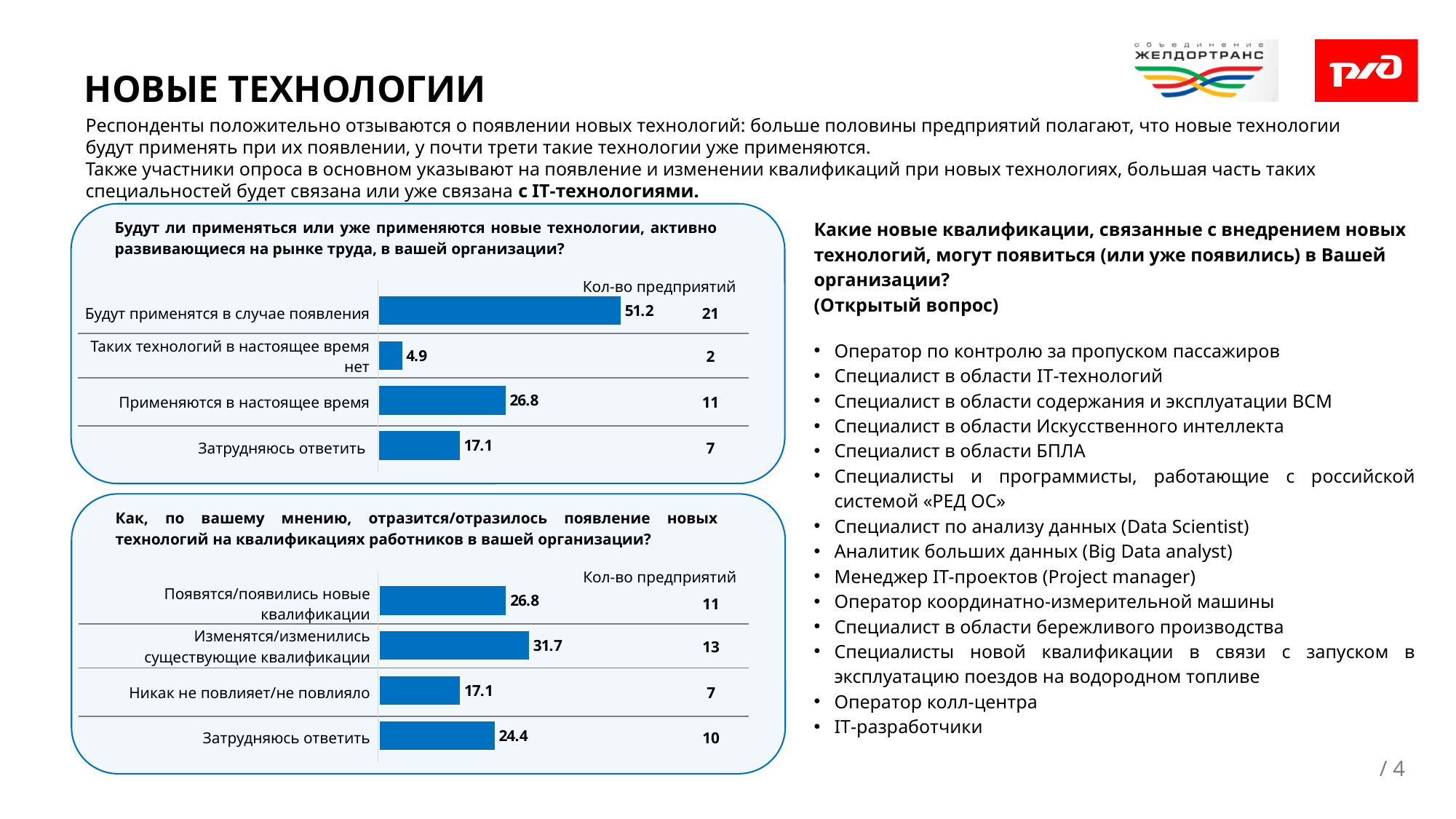
On the top chart ("Будут ли применяться или уже применяются новые технологии..."), what is the value for "Будут применятся в случае появления"? 51.2 What type of chart is used in the bottom chart? Bar chart On the top chart, how many enterprises (Кол-во предприятий) chose "Применяются в настоящее время"? 11 On the bottom chart, which category has the lowest value? Никак не повлияет/не повлияло On the top chart, which category has the lowest value? Таких технологий в настоящее время нет On the top chart, how many categories are shown? 4 On the top chart, which category has the highest value? Будут применятся в случае появления On the bottom chart ("Как, по вашему мнению, отразится/отразилось появление новых технологий..."), what is the value for "Изменятся/изменились существующие квалификации"? 31.7 On the top chart, what is the difference between the values for "Будут применятся в случае появления" and "Применяются в настоящее время"? 24.4 On the bottom chart, which category has the highest value? Изменятся/изменились существующие квалификации On the bottom chart, how many enterprises chose "Затрудняюсь ответить"? 10 On the bottom chart, which is larger: the value for "Появятся/появились новые квалификации" or for "Затрудняюсь ответить"? Появятся/появились новые квалификации